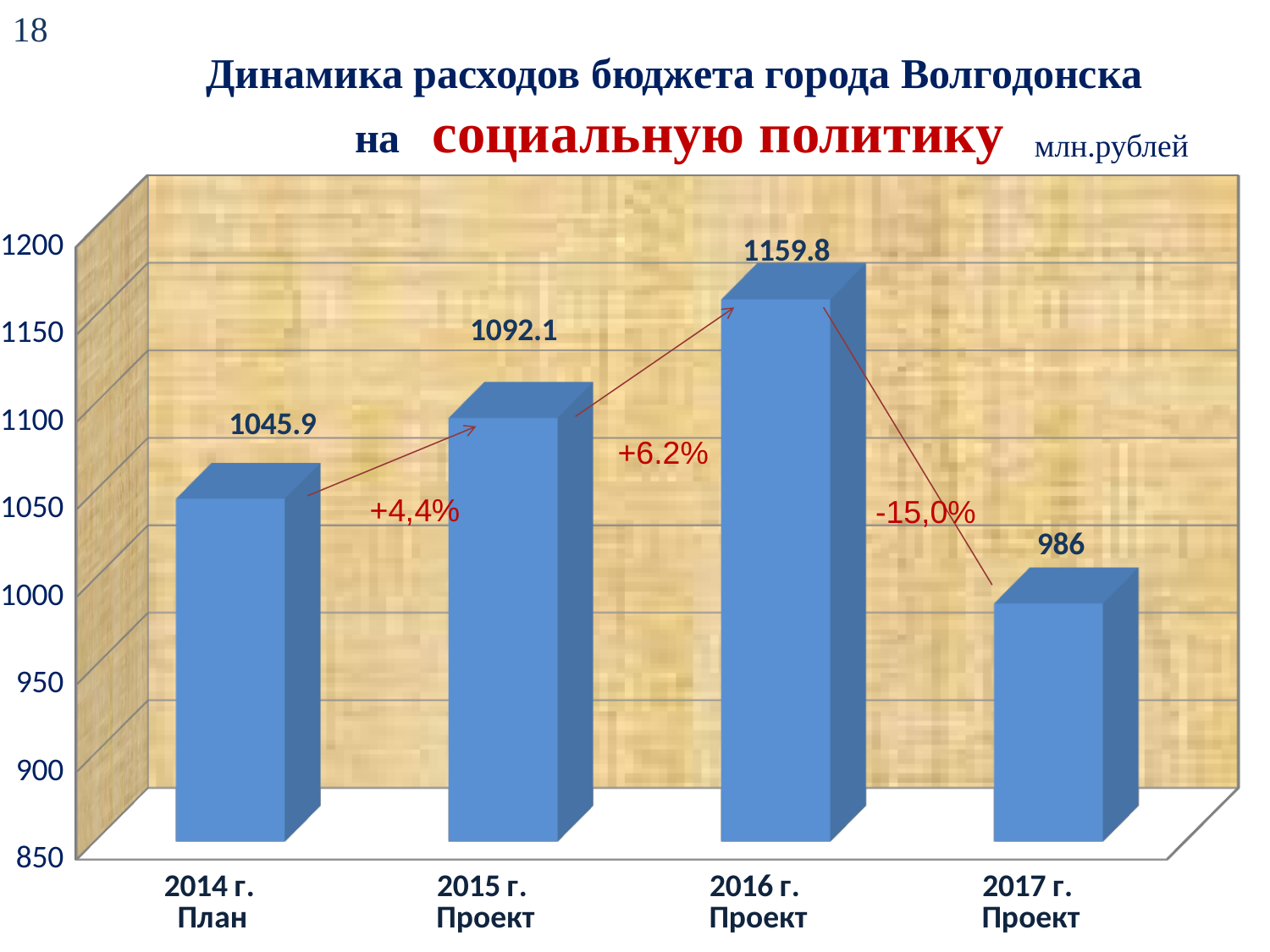
What kind of chart is shown on the slide? Bar chart What is the value for 2014 г. План? 1045.9 Which category has the highest value? 2016 г. Проект What unit of measurement is stated next to the chart title? млн.рублей What percentage change is labelled between 2015 г. Проект and 2016 г. Проект? +6.2% Which category has the lowest value? 2017 г. Проект How many categories are shown on the chart? 4 Which is larger, the value for 2014 г. План or the value for 2015 г. Проект? 2015 г. Проект What is the difference between the values for 2016 г. Проект and 2017 г. Проект? 173.8 What is the value for 2015 г. Проект? 1092.1 What is the value for 2016 г. Проект? 1159.8 What is the value for 2017 г. Проект? 986